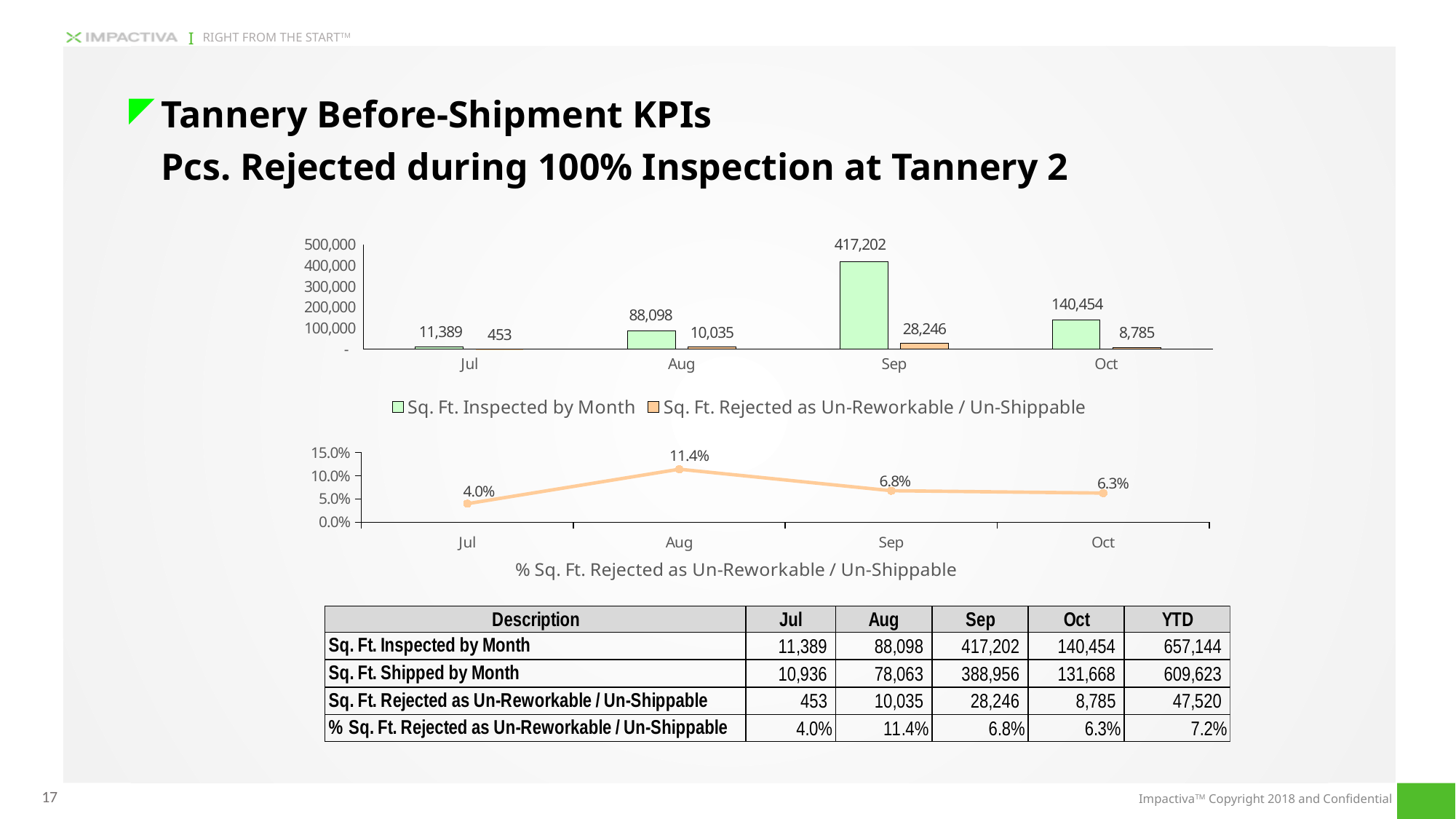
In the bottom line chart, which month has the lowest % Sq. Ft. Rejected as Un-Reworkable / Un-Shippable? Jul In the top bar chart, which month has the highest Sq. Ft. Inspected by Month? Sep What kind of chart is the top chart on the slide? Bar chart In the top bar chart, what is the difference between Sq. Ft. Inspected by Month for Oct and Sq. Ft. Rejected as Un-Reworkable / Un-Shippable for Oct? 131,669 How many months are plotted on the x axis of the bottom line chart? 4 In the top bar chart, what is the value of Sq. Ft. Inspected by Month for Sep? 417,202 How many series does the legend of the top bar chart list? 2 In the bottom line chart, does the % Sq. Ft. Rejected rise or fall from Aug to Oct? Fall In the bottom line chart, what is the % Sq. Ft. Rejected as Un-Reworkable / Un-Shippable for Aug? 11.4% In the top bar chart, is Sq. Ft. Inspected by Month larger for Aug or for Oct? Oct In the top bar chart, what is the value of Sq. Ft. Rejected as Un-Reworkable / Un-Shippable for Aug? 10,035 In the top bar chart, which month has the lowest Sq. Ft. Rejected as Un-Reworkable / Un-Shippable? Jul